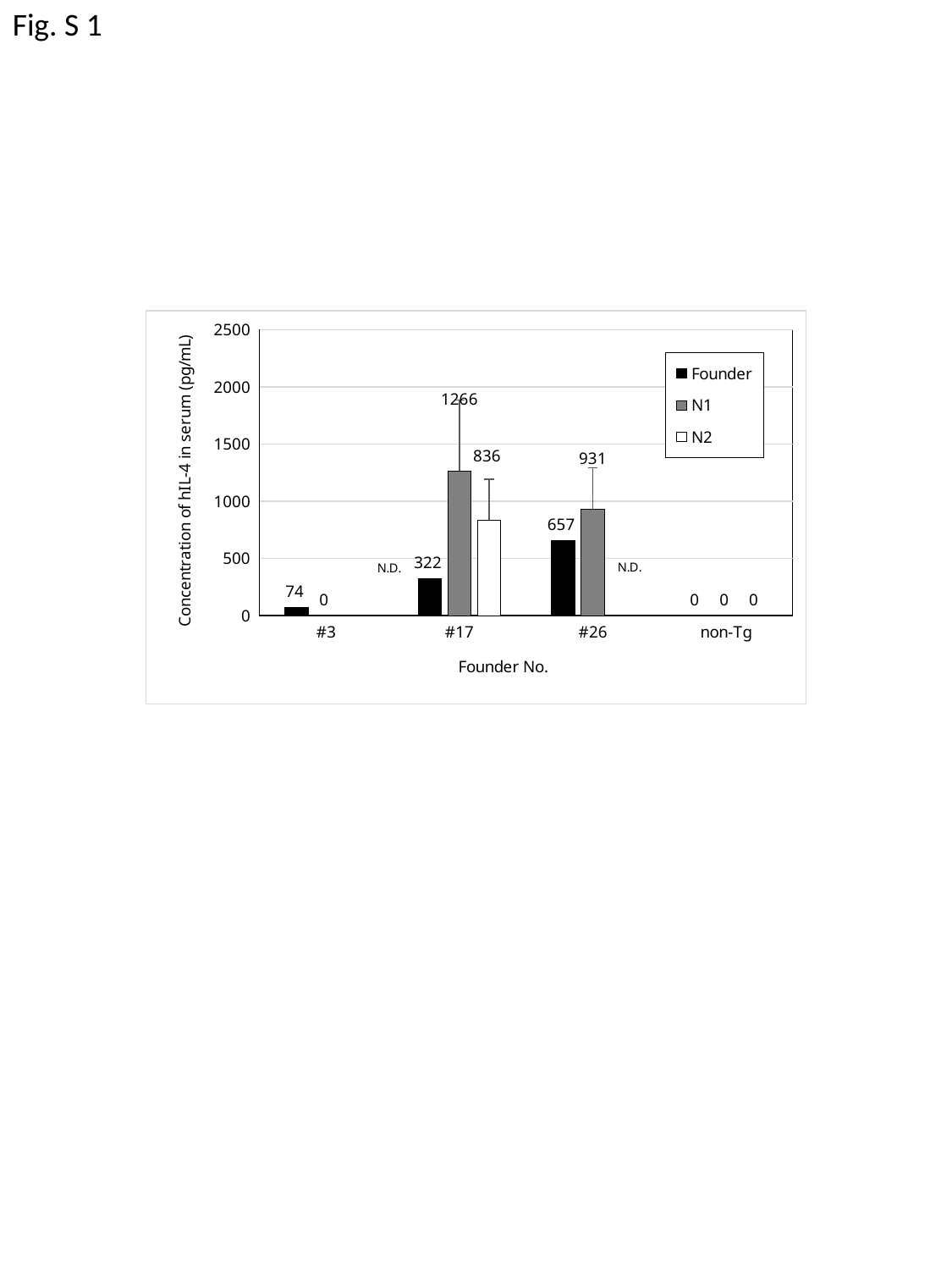
What is the Founder value for #26? 657 What is the N2 value for #17? 836 How many categories are shown on the x axis? 4 Which founder has the highest N1 value? #17 What is the Founder value for #17? 322 Which is larger, the Founder value for #26 or the Founder value for #17? #26 What is the y-axis label of the chart? Concentration of hIL-4 in serum (pg/mL) What is the Founder value for #3? 74 How many series does the legend list? 3 What kind of chart is shown? bar chart What is the N1 value for #17? 1266 What is the difference between the N1 and N2 values for #17? 430